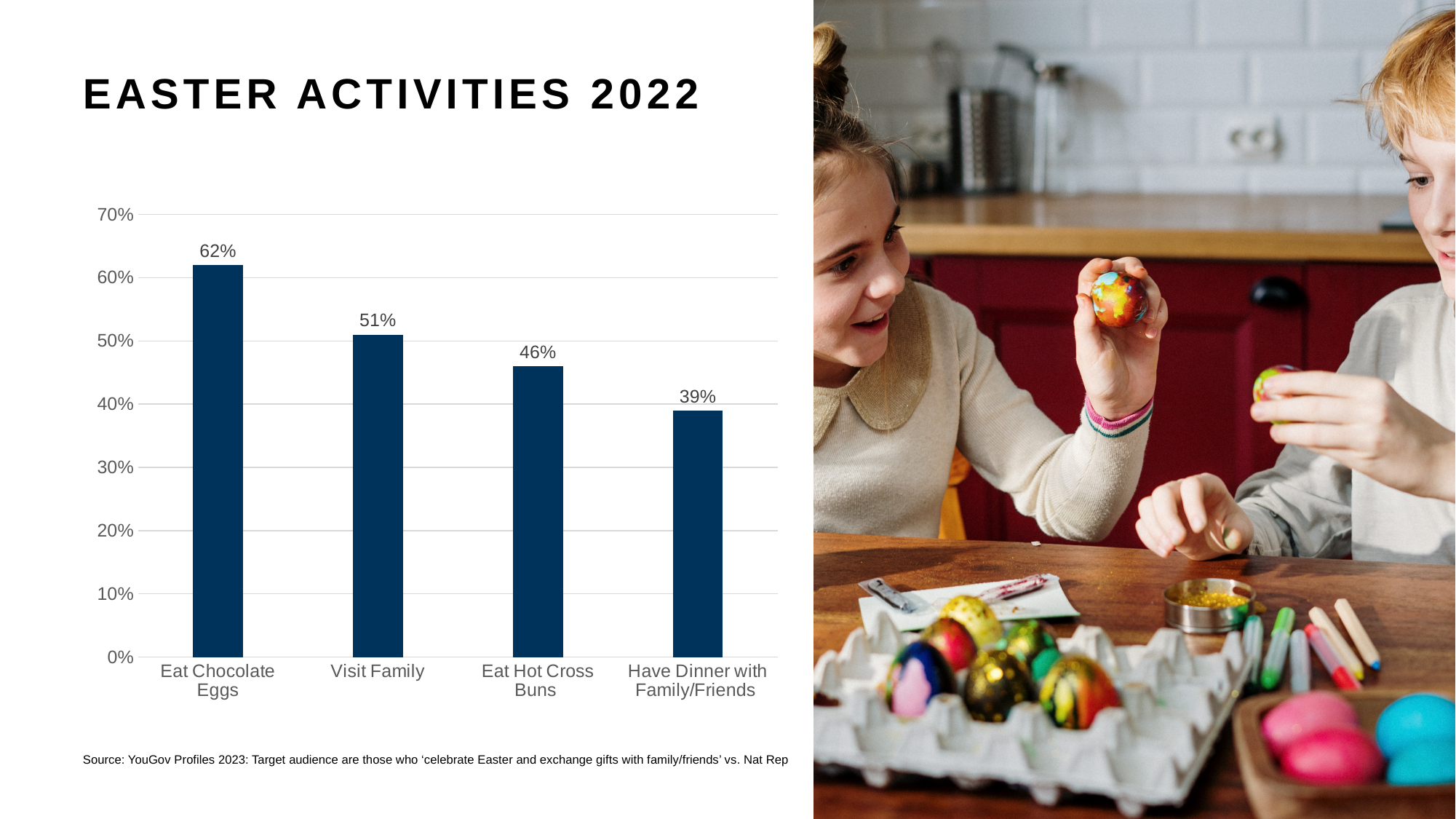
What kind of chart is shown on the slide? Bar chart What is the value for Visit Family? 51% What is the difference between the values for Eat Hot Cross Buns and Have Dinner with Family/Friends? 7% How many activities are shown in the chart? 4 What is the value for Eat Chocolate Eggs? 62% Which is larger, the value for Visit Family or the value for Eat Hot Cross Buns? Visit Family Do the values rise or fall from left to right across the categories? Fall What is the value for Eat Hot Cross Buns? 46% What is the value for Have Dinner with Family/Friends? 39% Which activity has the highest value? Eat Chocolate Eggs What is the difference between the values for Eat Chocolate Eggs and Visit Family? 11% Which activity has the lowest value? Have Dinner with Family/Friends